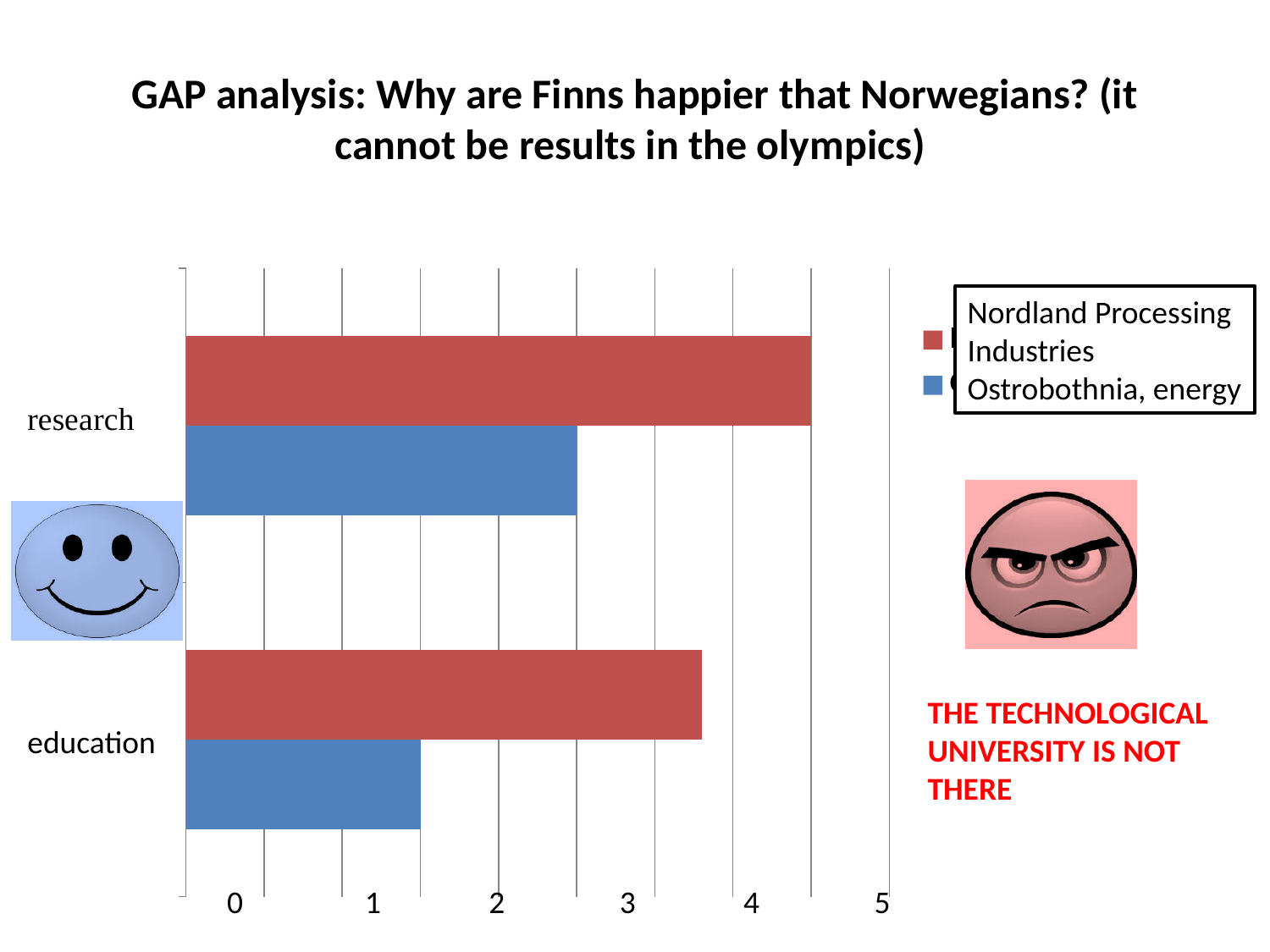
Which bar on the chart is the longest? Nordland Processing Industries, research What kind of chart is shown on the slide? bar chart Which series is shown in red on the chart? Nordland Processing Industries How many categories are shown on the chart's vertical axis? 2 Is the value for Ostrobothnia, energy in education greater or less than 2? less How many series does the chart's legend list? 2 Which series is shown in blue on the chart? Ostrobothnia, energy Is the value for Nordland Processing Industries in research greater or less than 4? greater Is the value for Ostrobothnia, energy in research greater or less than 3? less For research, which series has the larger value, Nordland Processing Industries or Ostrobothnia, energy? Nordland Processing Industries Which bar on the chart is the shortest? Ostrobothnia, energy, education